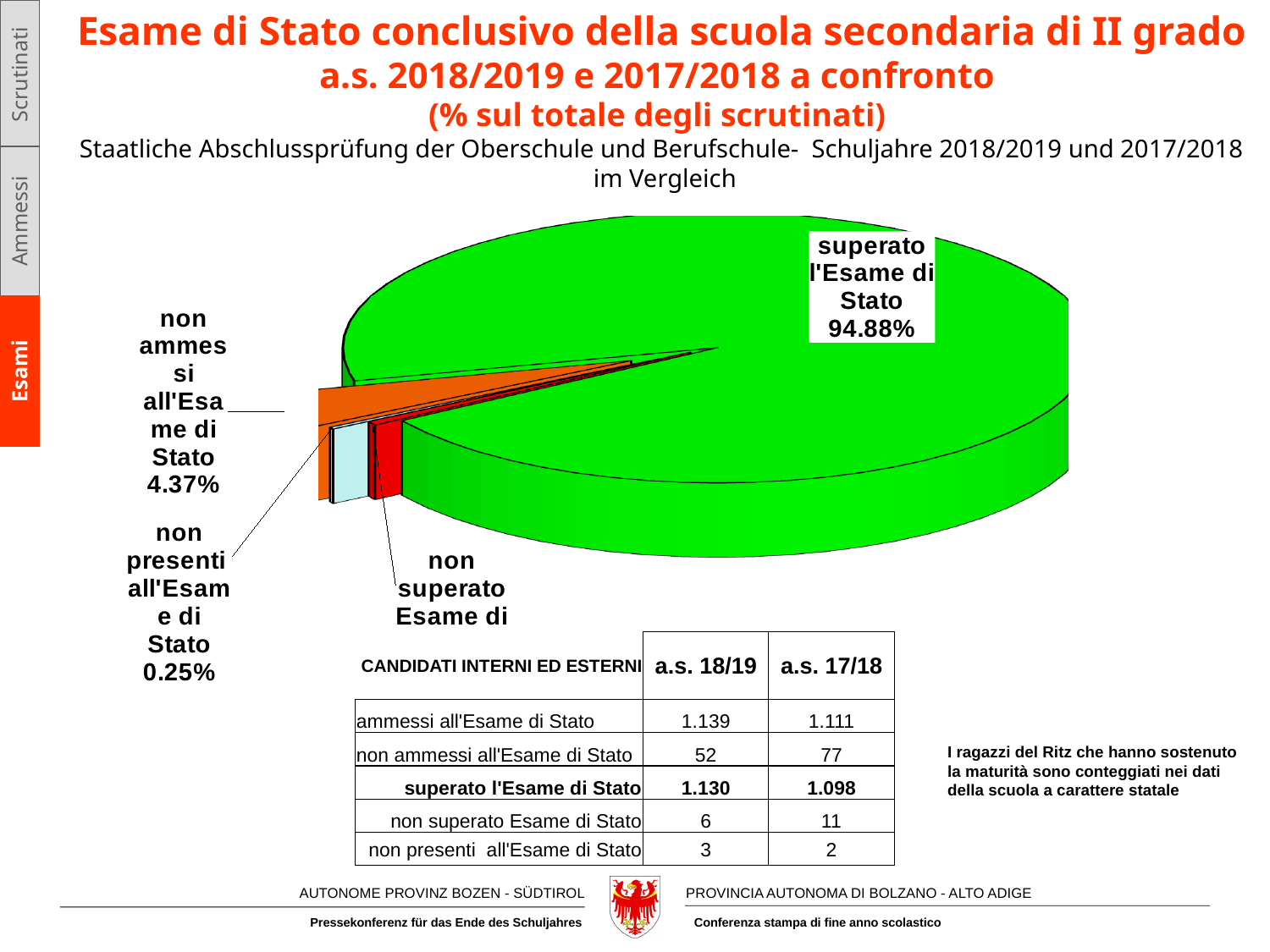
What colour is the "superato l'Esame di Stato" slice in the pie chart? green What percentage does the pie chart show for "non ammessi all'Esame di Stato"? 4.37% What is the difference between the "non ammessi all'Esame di Stato" share and the "non presenti all'Esame di Stato" share in the pie chart? 4.12% What percentage does the pie chart show for "non presenti all'Esame di Stato"? 0.25% By how many percentage points does the "superato l'Esame di Stato" slice exceed the "non ammessi all'Esame di Stato" slice? 90.51% How many slices does the pie chart have? 4 What colour is the "non ammessi all'Esame di Stato" slice in the pie chart? orange What percentage of the pie chart is labelled for "superato l'Esame di Stato"? 94.88% Which is larger in the pie chart: the share for "non ammessi all'Esame di Stato" or for "non presenti all'Esame di Stato"? non ammessi all'Esame di Stato What kind of chart is shown on the slide? pie chart Which slice of the pie chart is the largest? superato l'Esame di Stato